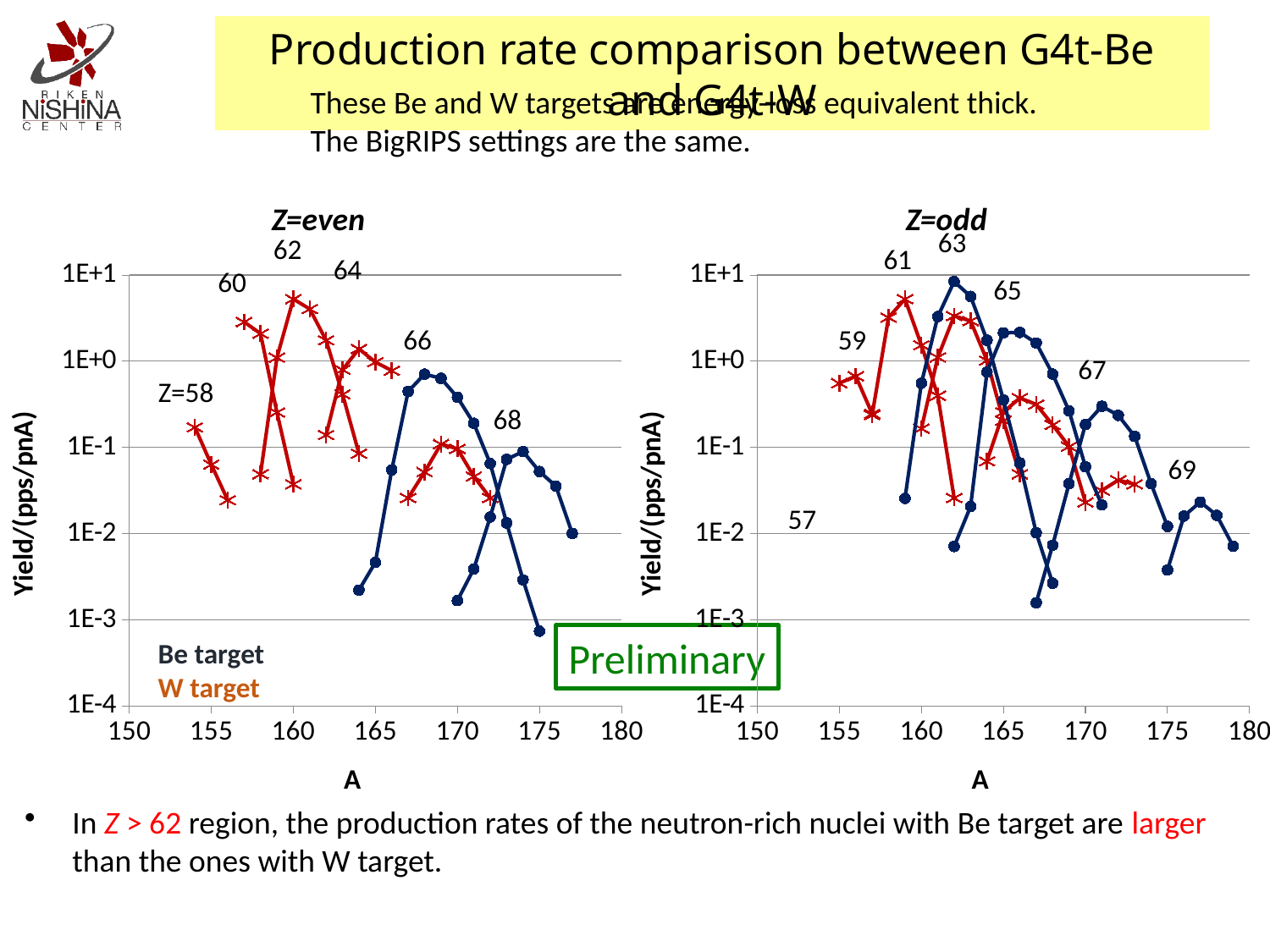
What is the y-axis label of the Z=odd chart? Yield/(pps/pnA) In the Z=even chart, do the peak yields of the Be target curves rise or fall as A increases? fall What kind of chart is the Z=even chart? line chart In the Z=even chart, which series is drawn in blue? Be target How many series does the legend of the Z=even chart list? 2 In the Z=odd chart, which Z value has the highest peak yield? 63 How many Z values are labelled on the Z=even chart? 6 In the Z=even chart, is the peak value of the Z=66 Be target curve greater or less than 1E+0? less In the Z=odd chart, is the peak value of the Z=69 Be target curve greater or less than 1E-1? less How many Z values are labelled on the Z=odd chart? 7 In the Z=even chart, is the peak value of the Z=62 W target curve greater or less than 1E+0? greater